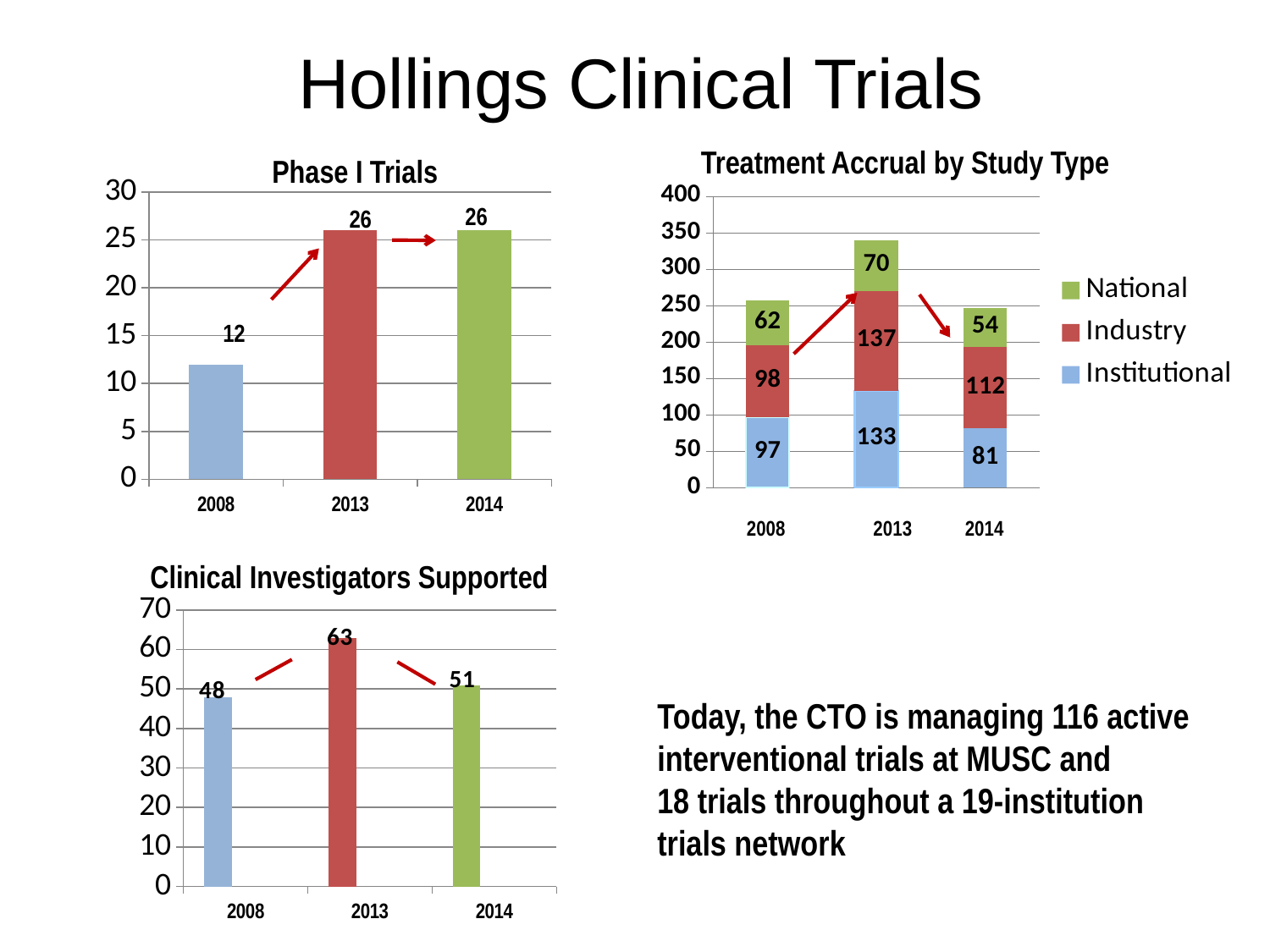
In the Clinical Investigators Supported chart, what is the difference between the 2013 and 2014 values? 12 In the Phase I Trials chart, what is the value for 2013? 26 In the Treatment Accrual by Study Type chart, what is the total of the stacked bar for 2013? 340 In the Clinical Investigators Supported chart, what is the value for 2013? 63 In the Treatment Accrual by Study Type chart, how many series does the legend list? 3 What kind of chart is the Clinical Investigators Supported chart? Bar chart In the Phase I Trials chart, which year has the lowest value? 2008 In the Treatment Accrual by Study Type chart, what is the Industry value for 2013? 137 In the Phase I Trials chart, what is the difference between the 2013 and 2008 values? 14 In the Phase I Trials chart, what is the value for 2008? 12 In the Treatment Accrual by Study Type chart, what is the Institutional value for 2014? 81 In the Treatment Accrual by Study Type chart, which is larger, the National value for 2008 or the National value for 2014? National value for 2008